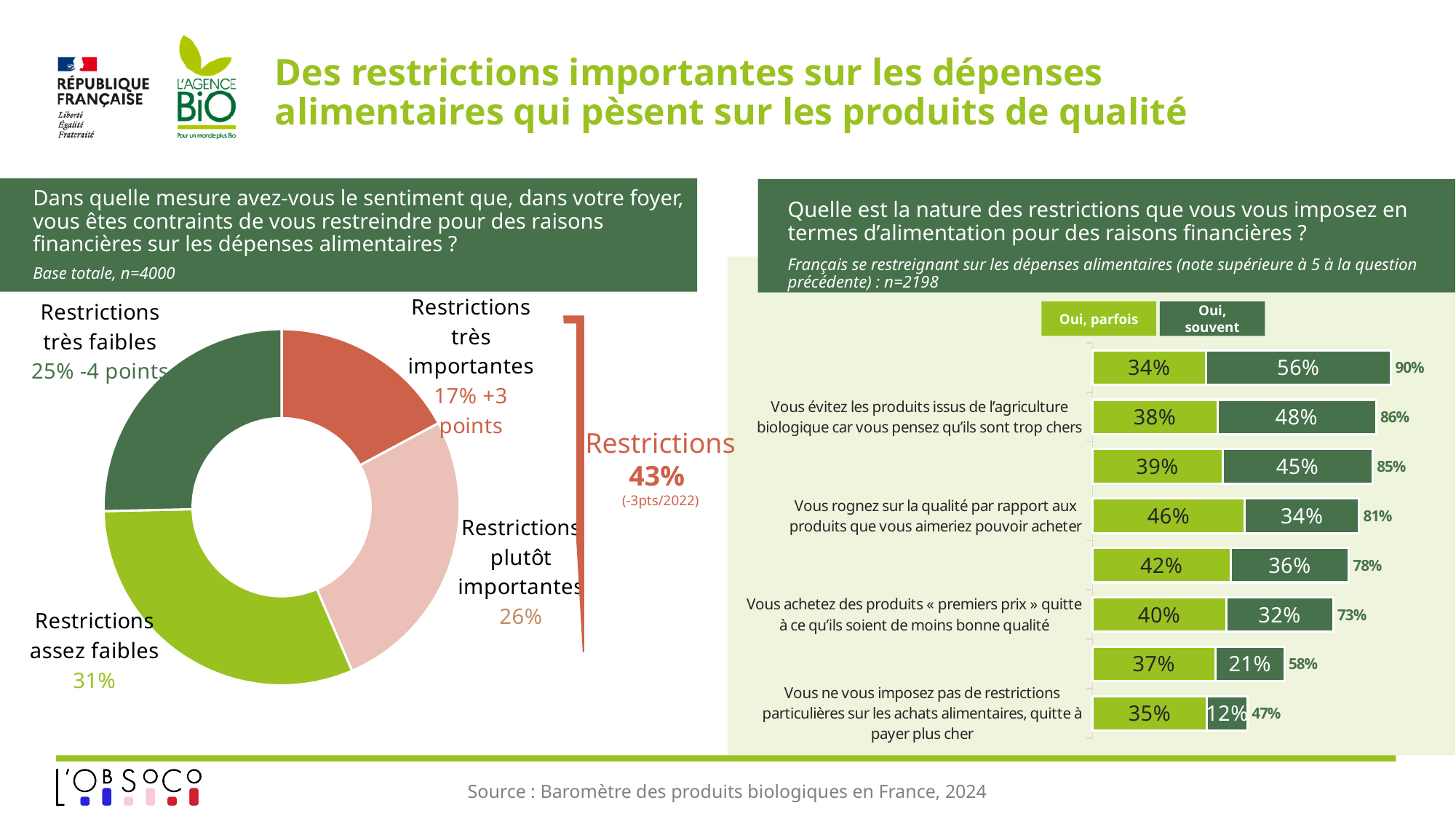
In the donut chart on the left, what is the difference in percentage points between "Restrictions assez faibles" and "Restrictions très importantes"? 14 points In the stacked bar chart on the right, what is the "Oui, souvent" value in the bottommost bar? 12% In the donut chart on the left, what share is shown for "Restrictions assez faibles"? 31% In the donut chart on the left, which category has the smallest share? Restrictions très importantes In the donut chart on the left, how many categories are shown? 4 In the donut chart on the left, which category has the largest share? Restrictions assez faibles In the stacked bar chart on the right, how many series does the legend list? 2 In the donut chart on the left, what share is shown for "Restrictions très importantes"? 17% What kind of chart is shown on the left of the slide? Donut (pie) chart In the stacked bar chart on the right, how many bars are shown? 8 In the stacked bar chart on the right, what is the total shown for the topmost bar? 90% In the stacked bar chart on the right, what are the two legend entries? Oui, parfois; Oui, souvent